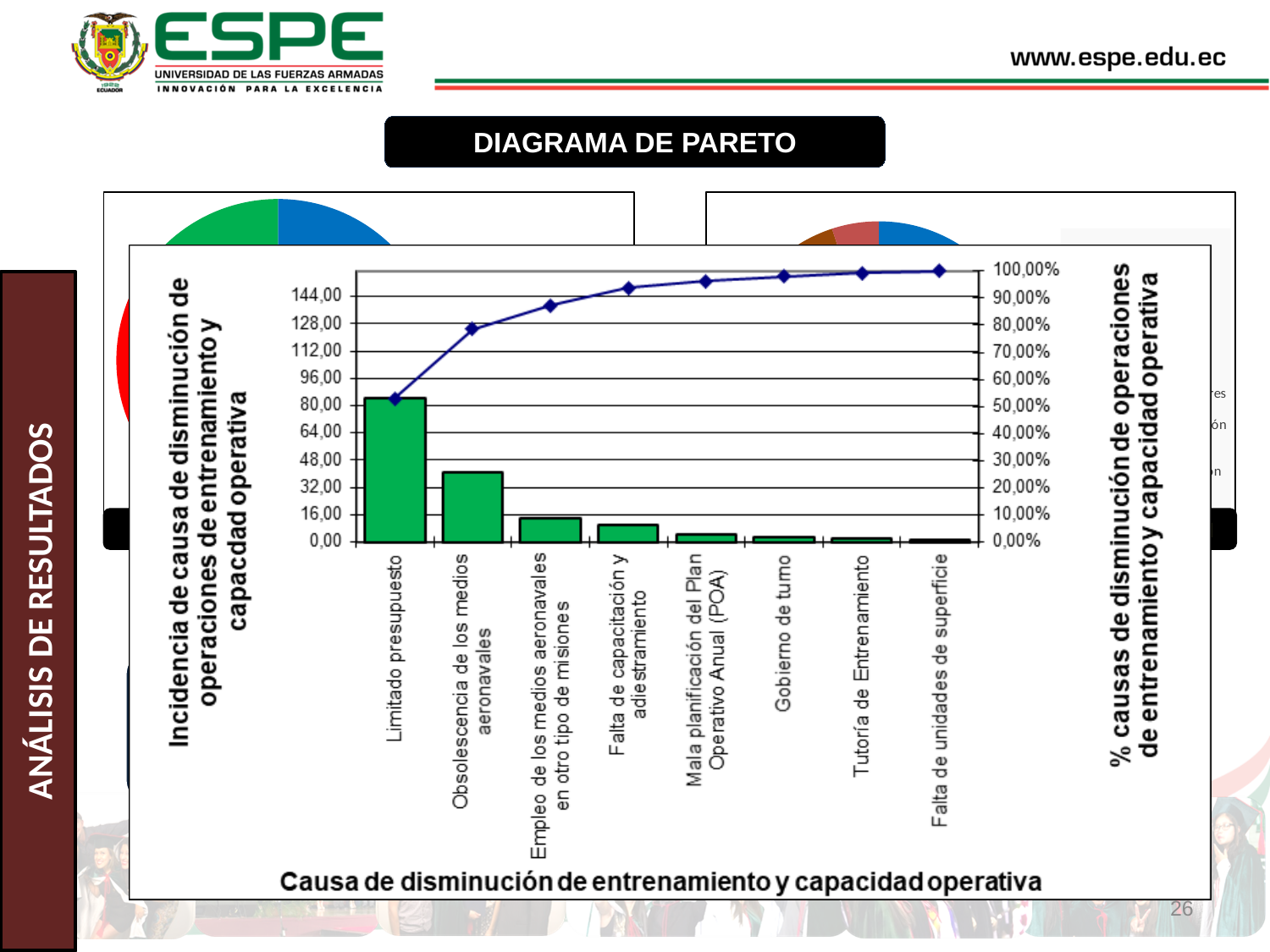
Does the cumulative percentage line rise or fall from left to right? rise Is the bar for Limitado presupuesto greater or less than 80,00? greater How many categories are shown on the x axis of the Pareto chart? 8 Which category has the shortest bar in the Pareto chart? Falta de unidades de superficie What cumulative percentage does the line reach at the last category, Falta de unidades de superficie? 100,00% What is the label of the x axis of the Pareto chart? Causa de disminución de entrenamiento y capacidad operativa Is the bar for Empleo de los medios aeronavales en otro tipo de misiones greater or less than 32,00? less Do the bar values rise or fall from left to right along the x axis? fall Is the bar for Obsolescencia de los medios aeronavales greater or less than 48,00? less Which category has the tallest bar in the Pareto chart? Limitado presupuesto What is the title shown above the chart on the slide? DIAGRAMA DE PARETO Which bar is taller: Obsolescencia de los medios aeronavales or Falta de capacitación y adiestramiento? Obsolescencia de los medios aeronavales